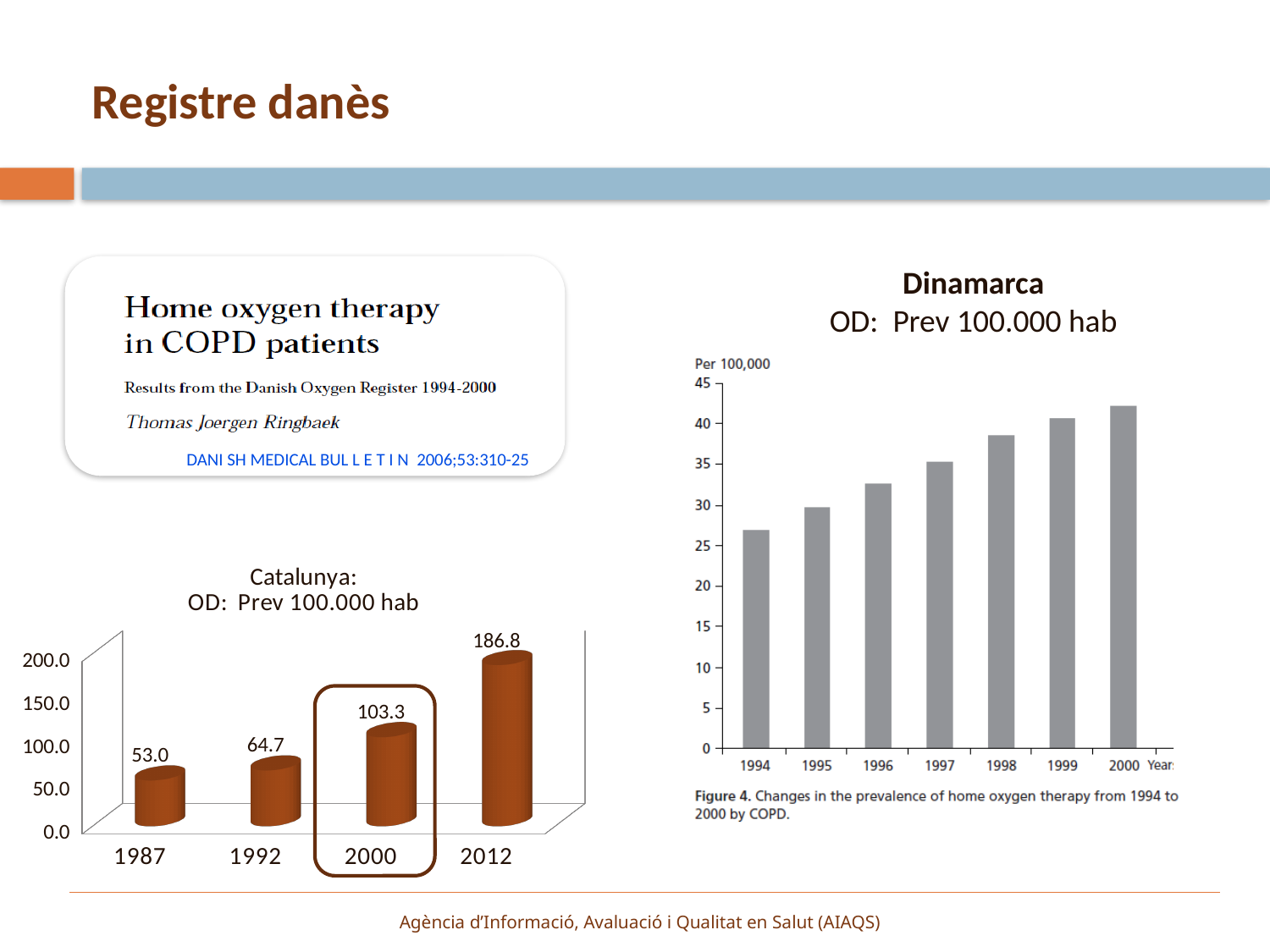
In the Dinamarca chart, is the value for 1994 greater or less than 30? less In the Dinamarca chart, how many years are shown? 7 In the Dinamarca chart, is the value for 2000 greater or less than 40? greater In the Catalunya chart, do the values rise or fall from 1987 to 2012? rise In the Dinamarca chart, which year has the highest value? 2000 In the Catalunya chart, what is the value for 1987? 53.0 In the Catalunya chart, which year has the lowest value? 1987 In the Catalunya chart, what is the value for 2000? 103.3 In the Catalunya chart, which year has the highest value? 2012 In the Catalunya chart, what is the difference between the values for 1992 and 1987? 11.7 In the Catalunya chart, how many years are shown? 4 In the Catalunya chart, what is the difference between the values for 2012 and 2000? 83.5